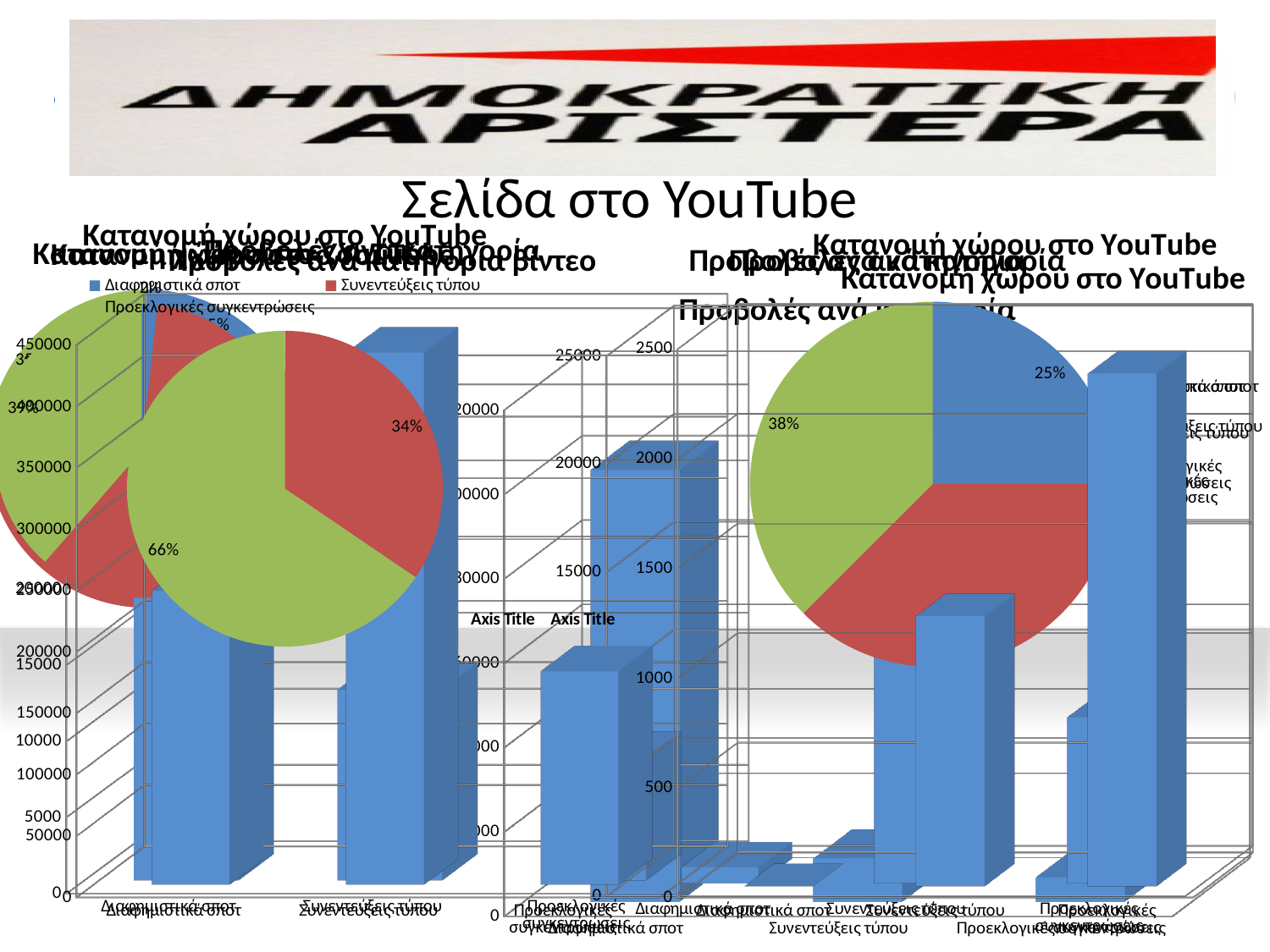
How many entries does the legend at the top left of the slide list? 3 What kind of chart is the chart in the middle of the slide with a vertical axis running from 0 to 2500? bar chart In the large pie chart on the left of the slide, which slice is the largest? the green slice (66%) In the pie chart on the right of the slide, which labelled slice is larger, the blue one or the green one? the green one (38%) In the large pie chart on the left of the slide, what percentage is shown on the green slice? 66% What is the title of the pie chart on the right of the slide? Κατανομή χώρου στο YouTube In the pie chart on the right of the slide, what percentage is shown on the green slice? 38% What kind of chart is the chart on the left showing 66% and 34%? pie chart In the large pie chart on the left of the slide, what percentage is shown on the red slice? 34% In the large pie chart on the left of the slide, what is the difference between the green slice's share and the red slice's share? 32 percentage points In the pie chart on the right of the slide, what percentage is shown on the blue slice? 25% In the pie chart on the right of the slide, how many slices does the pie have? 3